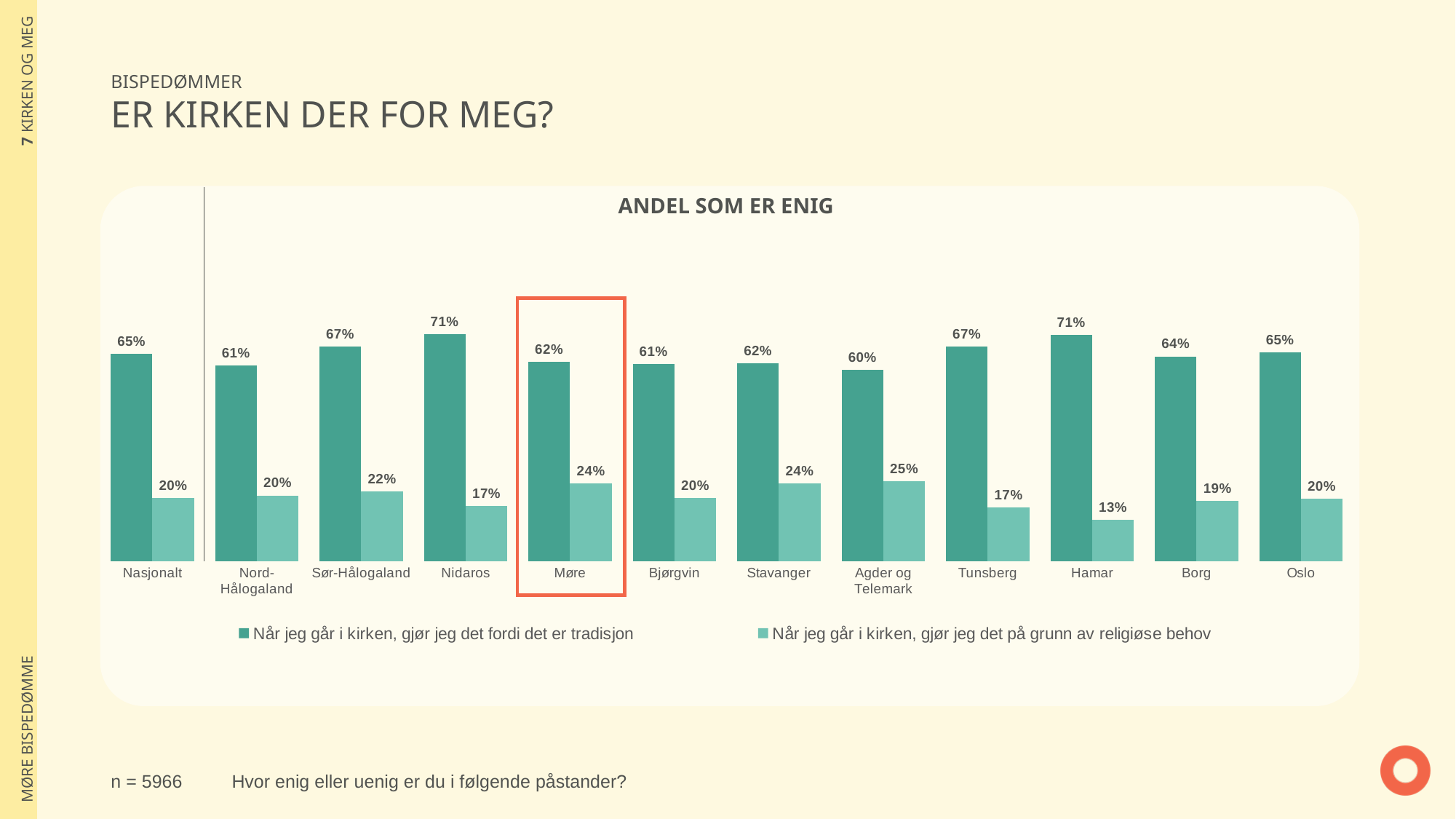
What kind of chart is shown on the slide? Bar chart What is the value for Hamar in the series "Når jeg går i kirken, gjør jeg det på grunn av religiøse behov"? 13% How many series does the legend list? 2 Which category is highlighted with an orange box on the chart? Møre Which category has the lowest value in the series "Når jeg går i kirken, gjør jeg det på grunn av religiøse behov"? Hamar Which is larger in the series "Når jeg går i kirken, gjør jeg det fordi det er tradisjon": Nidaros or Møre? Nidaros How many categories are shown on the x axis of the chart? 12 Which category has the highest value in the series "Når jeg går i kirken, gjør jeg det på grunn av religiøse behov"? Agder og Telemark What is the difference between the two series values for Møre? 38 percentage points What is the value for Nasjonalt in the series "Når jeg går i kirken, gjør jeg det fordi det er tradisjon"? 65% Which category has the lowest value in the series "Når jeg går i kirken, gjør jeg det fordi det er tradisjon"? Agder og Telemark What is the value for Møre in the series "Når jeg går i kirken, gjør jeg det fordi det er tradisjon"? 62%